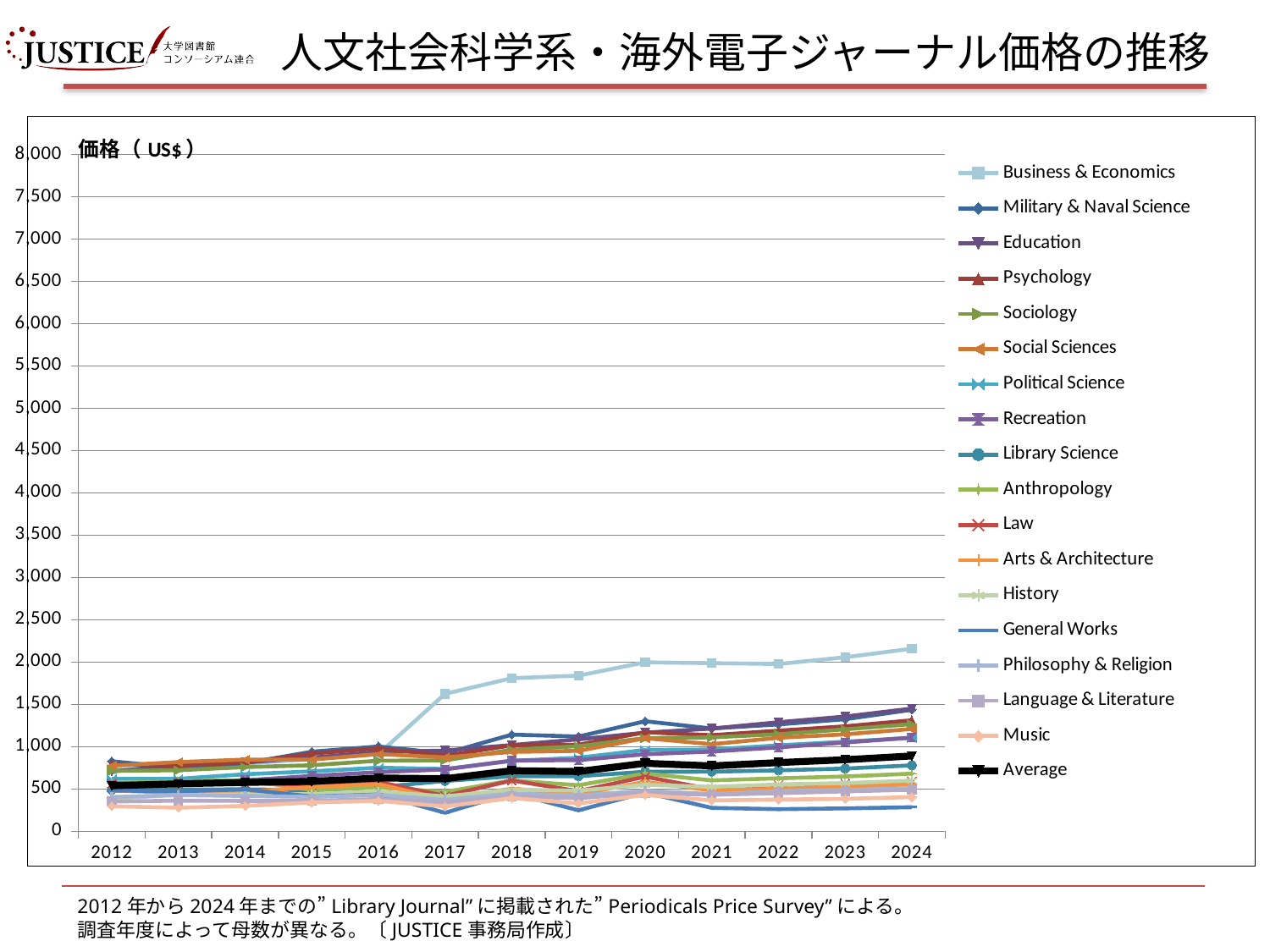
In 2024, which is larger: Business & Economics or Average? Business & Economics How many series does the legend list? 18 What is the label shown at the top of the y axis? 価格（US$） Is the value for Average in 2024 greater or less than 1,000? less Is the value for Business & Economics in 2012 greater or less than 1,000? less Which series has the highest value in 2024? Business & Economics Does the Business & Economics line rise or fall from 2012 to 2024? rise What is the highest tick value shown on the y axis? 8,000 Is the value for Business & Economics in 2024 greater or less than 2,000? greater How many years are plotted along the x axis? 13 Which series has the lowest value in 2024? General Works What kind of chart is shown on the slide? line chart